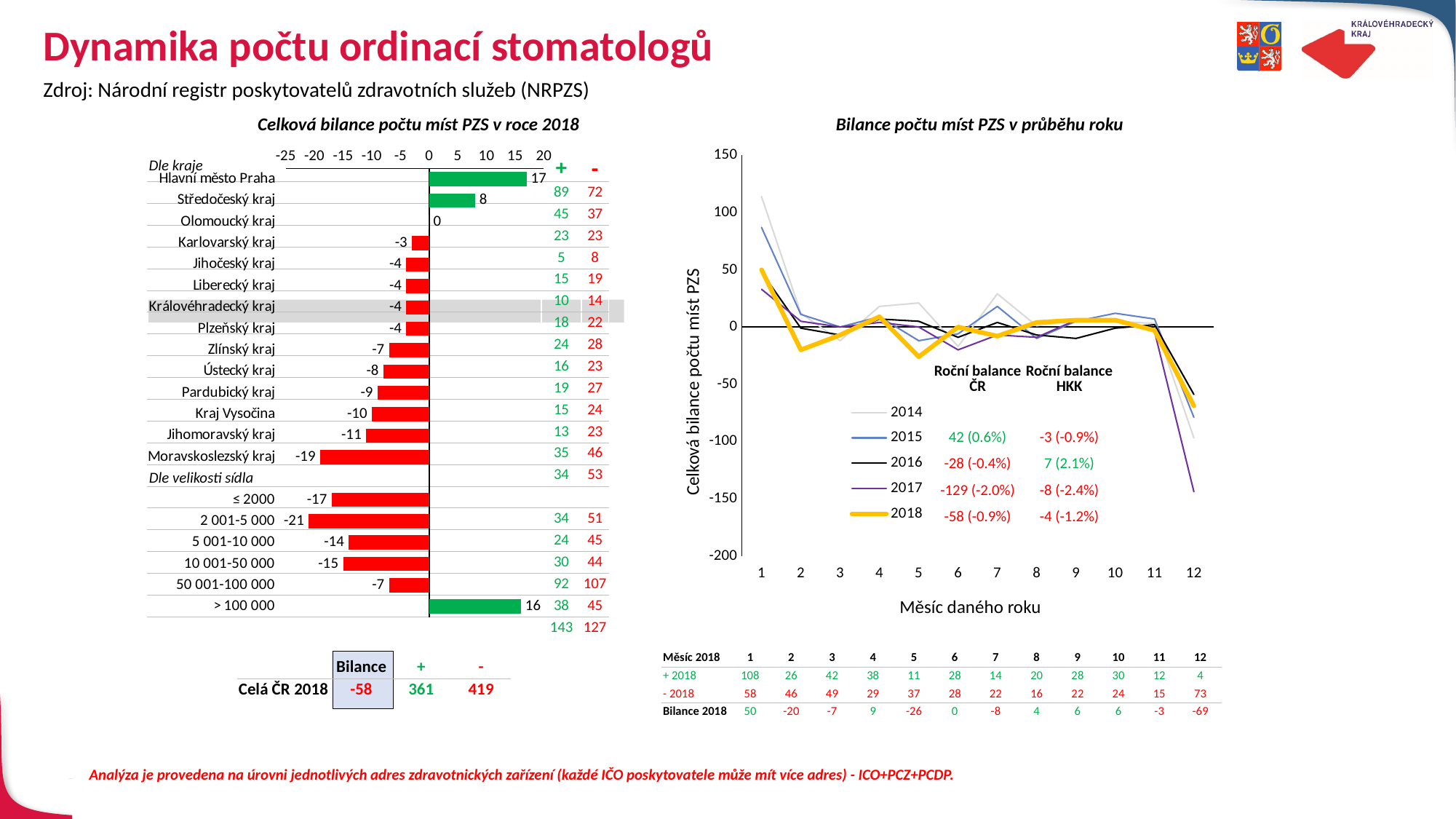
In the chart 'Bilance počtu míst PZS v průběhu roku', what is the value of the 2018 series in month 12? -69 In the chart 'Celková bilance počtu míst PZS v roce 2018', what is the value for Hlavní město Praha? 17 In the chart 'Celková bilance počtu míst PZS v roce 2018', which region (kraj) has the lowest value? Moravskoslezský kraj In the chart 'Celková bilance počtu míst PZS v roce 2018', which is larger: the value for Kraj Vysočina or the value for Jihomoravský kraj? Kraj Vysočina In the chart 'Bilance počtu míst PZS v průběhu roku', is the value of the 2014 series in month 1 greater or less than 100? greater In the chart 'Celková bilance počtu míst PZS v roce 2018', which category has the highest value? Hlavní město Praha What kind of chart is 'Celková bilance počtu míst PZS v roce 2018'? Bar chart How many series does the legend of the chart 'Bilance počtu míst PZS v průběhu roku' list? 5 In the chart 'Celková bilance počtu míst PZS v roce 2018', what is the value for Moravskoslezský kraj? -19 What kind of chart is 'Bilance počtu míst PZS v průběhu roku'? Line chart In the chart 'Celková bilance počtu míst PZS v roce 2018', what is the value for the settlement size category '2 001-5 000'? -21 In the chart 'Celková bilance počtu míst PZS v roce 2018', what is the difference between the values for Hlavní město Praha and Středočeský kraj? 9